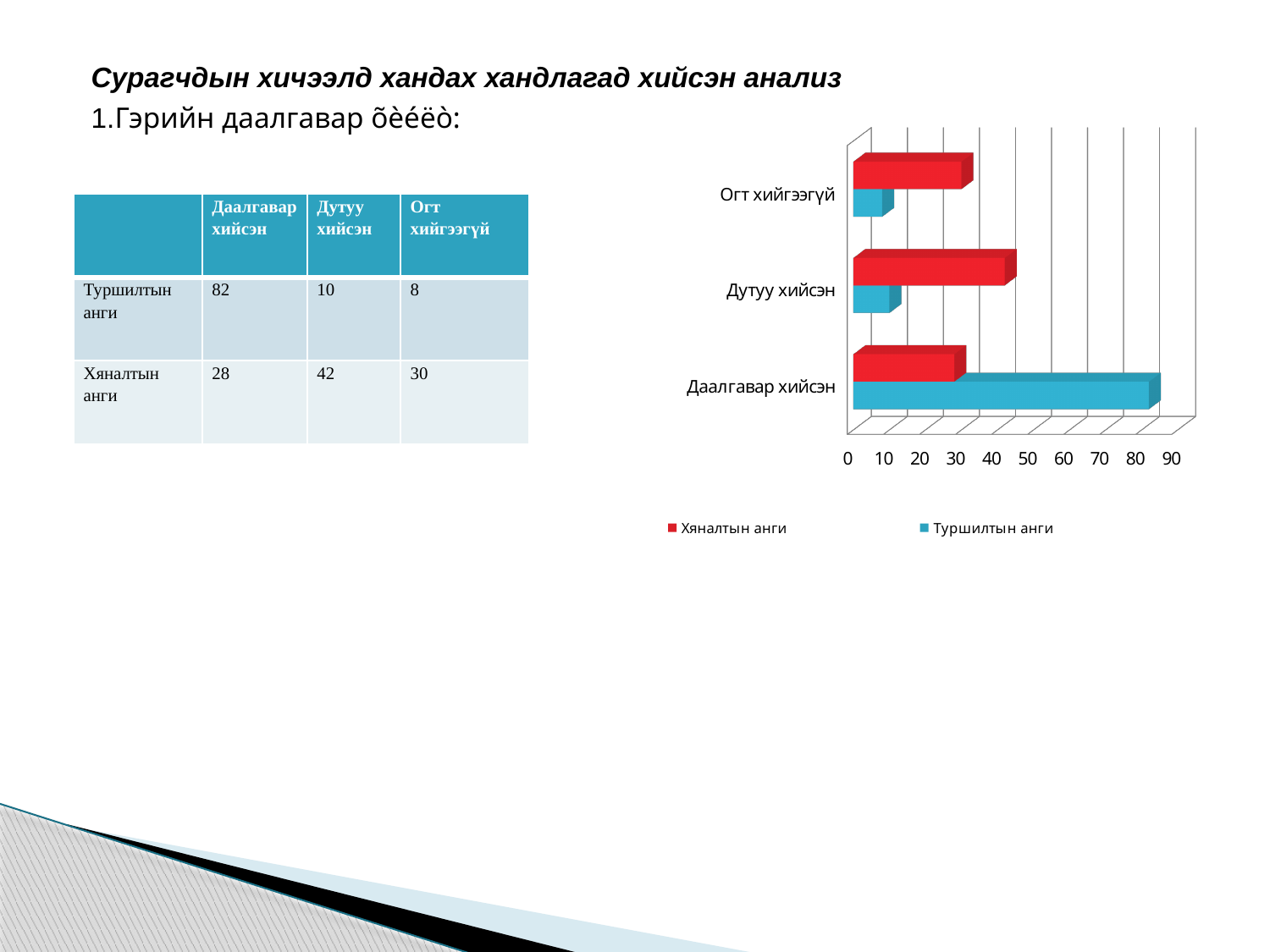
How many series does the chart's legend list? 2 Which series is shown in blue on the chart? Туршилтын анги For which category is the Хяналтын анги bar the longest? Дутуу хийсэн Is the value for Туршилтын анги in the Огт хийгээгүй category greater or less than 20? less Is the value for Туршилтын анги in the Даалгавар хийсэн category greater or less than 70? greater Is the value for Хяналтын анги in the Дутуу хийсэн category greater or less than 30? greater How many categories are shown on the chart's vertical axis? 3 In the Огт хийгээгүй category, which series has the larger value? Хяналтын анги In the Даалгавар хийсэн category, which series has the larger value? Туршилтын анги What kind of chart is shown on the slide? bar chart Which series is shown in red on the chart? Хяналтын анги For which category is the Туршилтын анги bar the longest? Даалгавар хийсэн